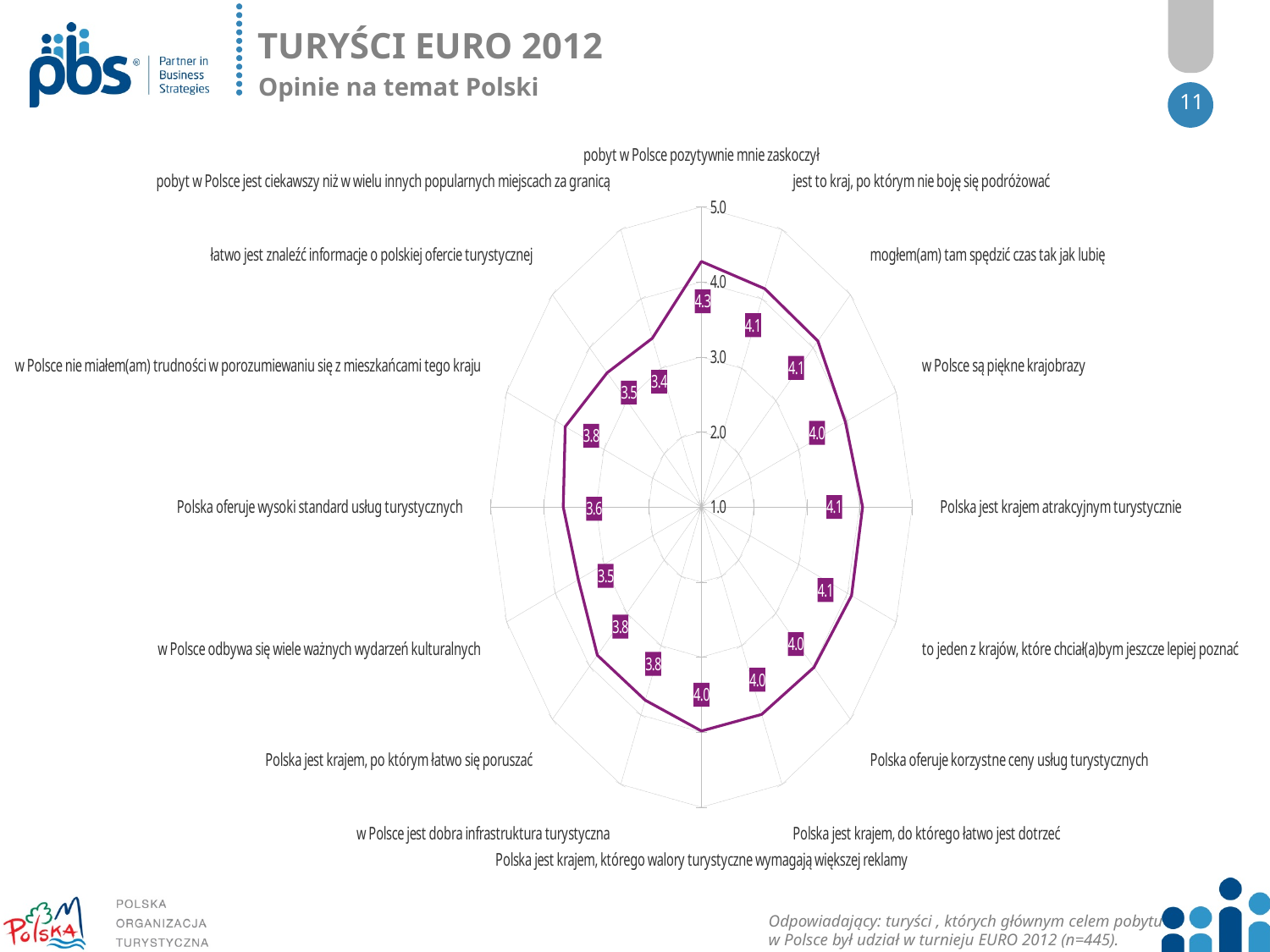
Which has a larger value: "w Polsce odbywa się wiele ważnych wydarzeń kulturalnych" or "Polska jest krajem, do którego łatwo jest dotrzeć"? Polska jest krajem, do którego łatwo jest dotrzeć What is the value for "pobyt w Polsce jest ciekawszy niż w wielu innych popularnych miejscach za granicą"? 3.4 What is the maximum value shown on the chart's scale? 5.0 What is the value for "pobyt w Polsce pozytywnie mnie zaskoczył"? 4.3 What is the value for "Polska jest krajem atrakcyjnym turystycznie"? 4.1 Which statement has the lowest value on the chart? pobyt w Polsce jest ciekawszy niż w wielu innych popularnych miejscach za granicą Which statement has the highest value on the chart? pobyt w Polsce pozytywnie mnie zaskoczył What is the value for "Polska oferuje wysoki standard usług turystycznych"? 3.6 What is the value for "w Polsce są piękne krajobrazy"? 4.0 What kind of chart is shown on the slide? Radar chart What is the difference between the values for "pobyt w Polsce pozytywnie mnie zaskoczył" and "Polska oferuje wysoki standard usług turystycznych"? 0.7 How many statements (categories) are plotted on the chart? 16